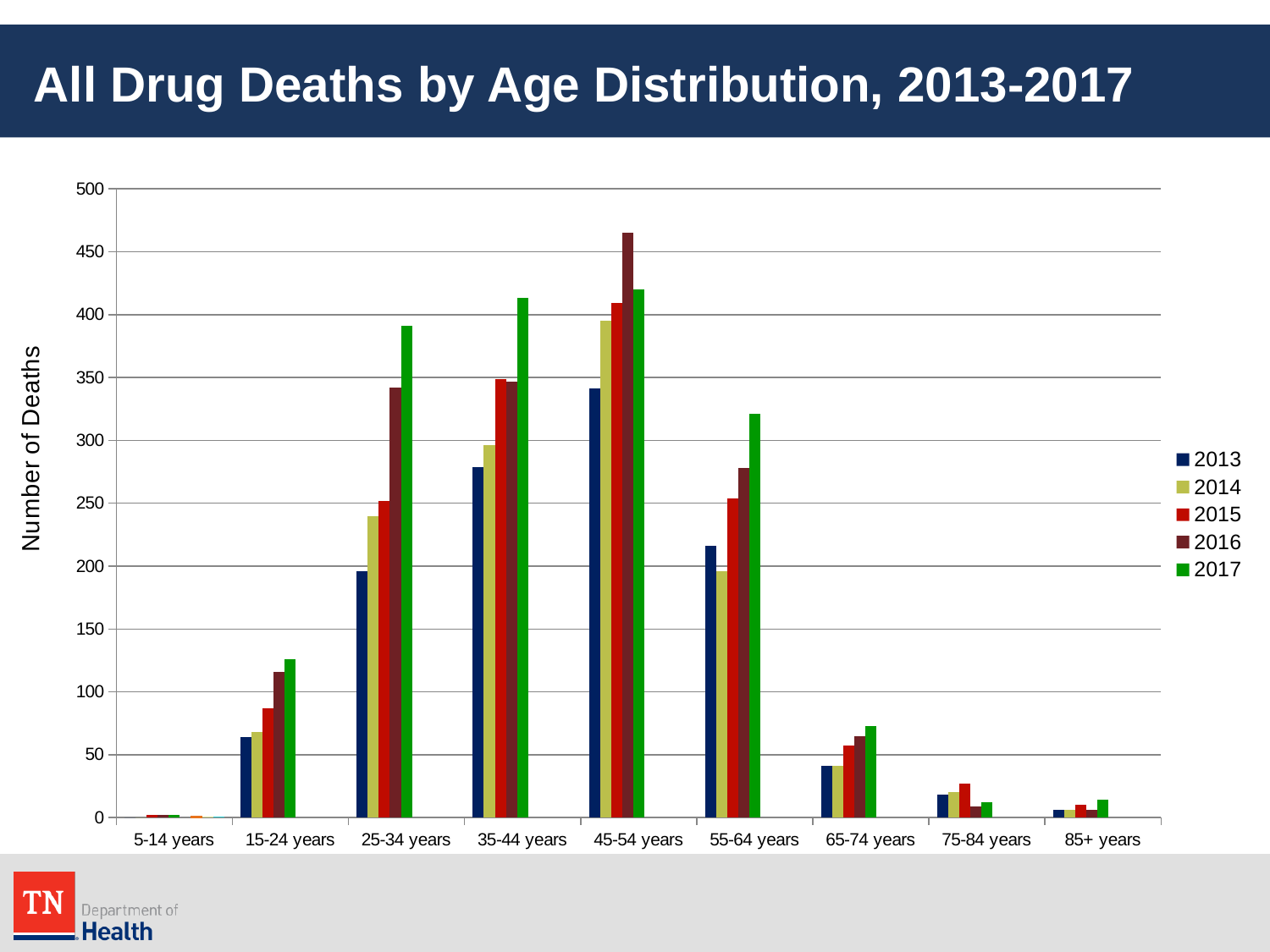
Which age group and year has the tallest bar in the chart? 45-54 years, 2016 For the 55-64 years group, which is larger: the 2013 value or the 2017 value? 2017 What kind of chart is shown on the slide? bar chart For the 45-54 years group, which is larger: the 2016 value or the 2017 value? 2016 How many series does the legend list? 5 How many age groups are shown on the x axis? 9 Which age group has the lowest bars across all years? 5-14 years Is the 2017 value for 25-34 years greater or less than 350? greater Is the 2013 value for 35-44 years greater or less than 250? greater For the 15-24 years group, do the values rise or fall from 2013 to 2017? rise Is the 2016 value for 55-64 years greater or less than 250? greater What is the title of the y axis? Number of Deaths